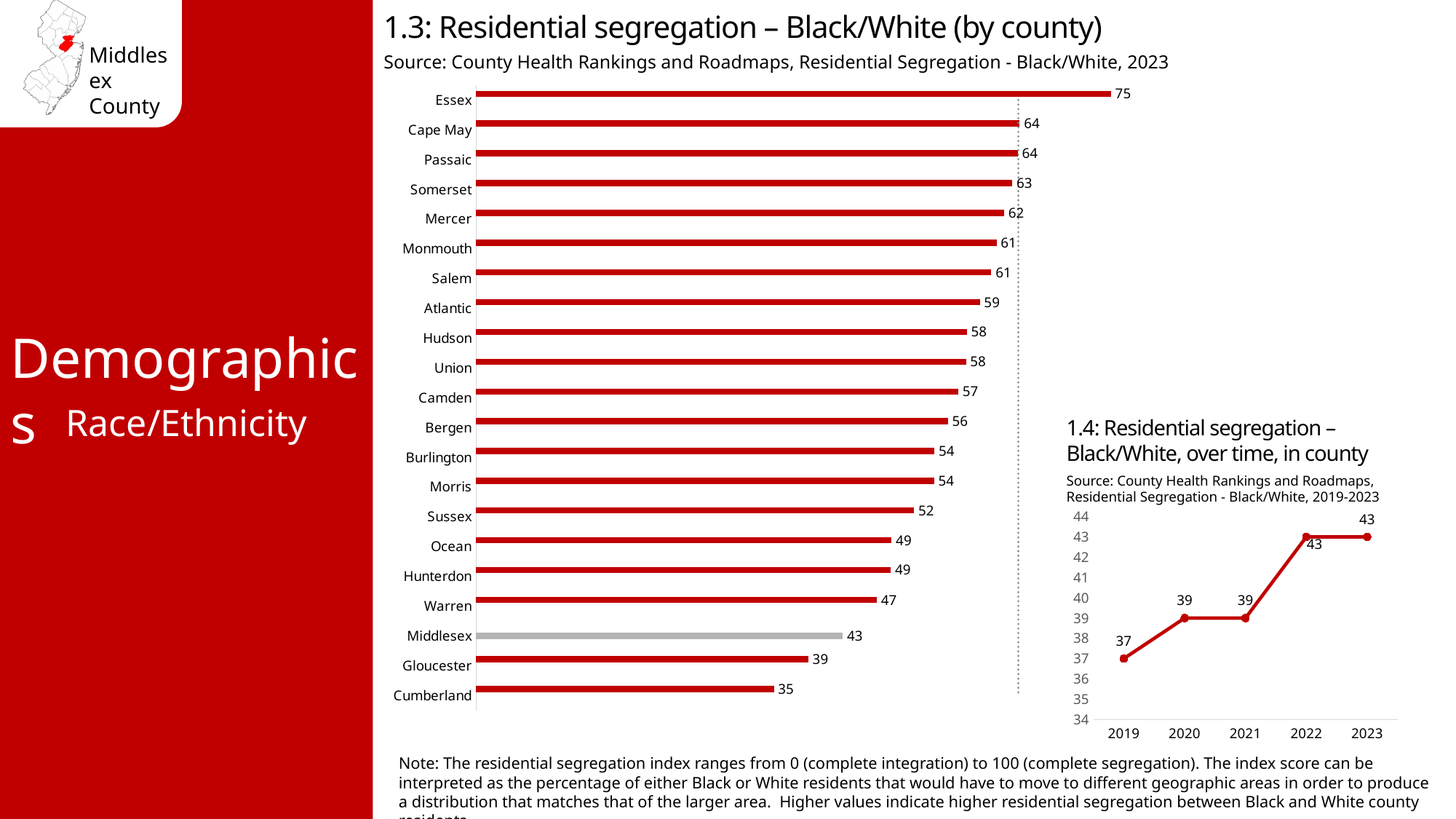
In the chart '1.3: Residential segregation – Black/White (by county)', how many counties are shown? 21 In the chart '1.3: Residential segregation – Black/White (by county)', what is the value for Middlesex? 43 In the chart '1.3: Residential segregation – Black/White (by county)', which county has the lowest value? Cumberland In the chart '1.3: Residential segregation – Black/White (by county)', which has a larger value, Bergen or Sussex? Bergen In the chart '1.4: Residential segregation – Black/White, over time, in county', what is the difference between the values for 2022 and 2021? 4 What kind of chart is '1.4: Residential segregation – Black/White, over time, in county'? Line chart In the chart '1.3: Residential segregation – Black/White (by county)', which county has the highest value? Essex In the chart '1.4: Residential segregation – Black/White, over time, in county', do the values rise or fall from 2019 to 2023? Rise What kind of chart is '1.3: Residential segregation – Black/White (by county)'? Bar chart In the chart '1.4: Residential segregation – Black/White, over time, in county', what is the value for 2019? 37 In the chart '1.3: Residential segregation – Black/White (by county)', what is the difference between the values for Essex and Cumberland? 40 In the chart '1.3: Residential segregation – Black/White (by county)', what is the value for Gloucester? 39